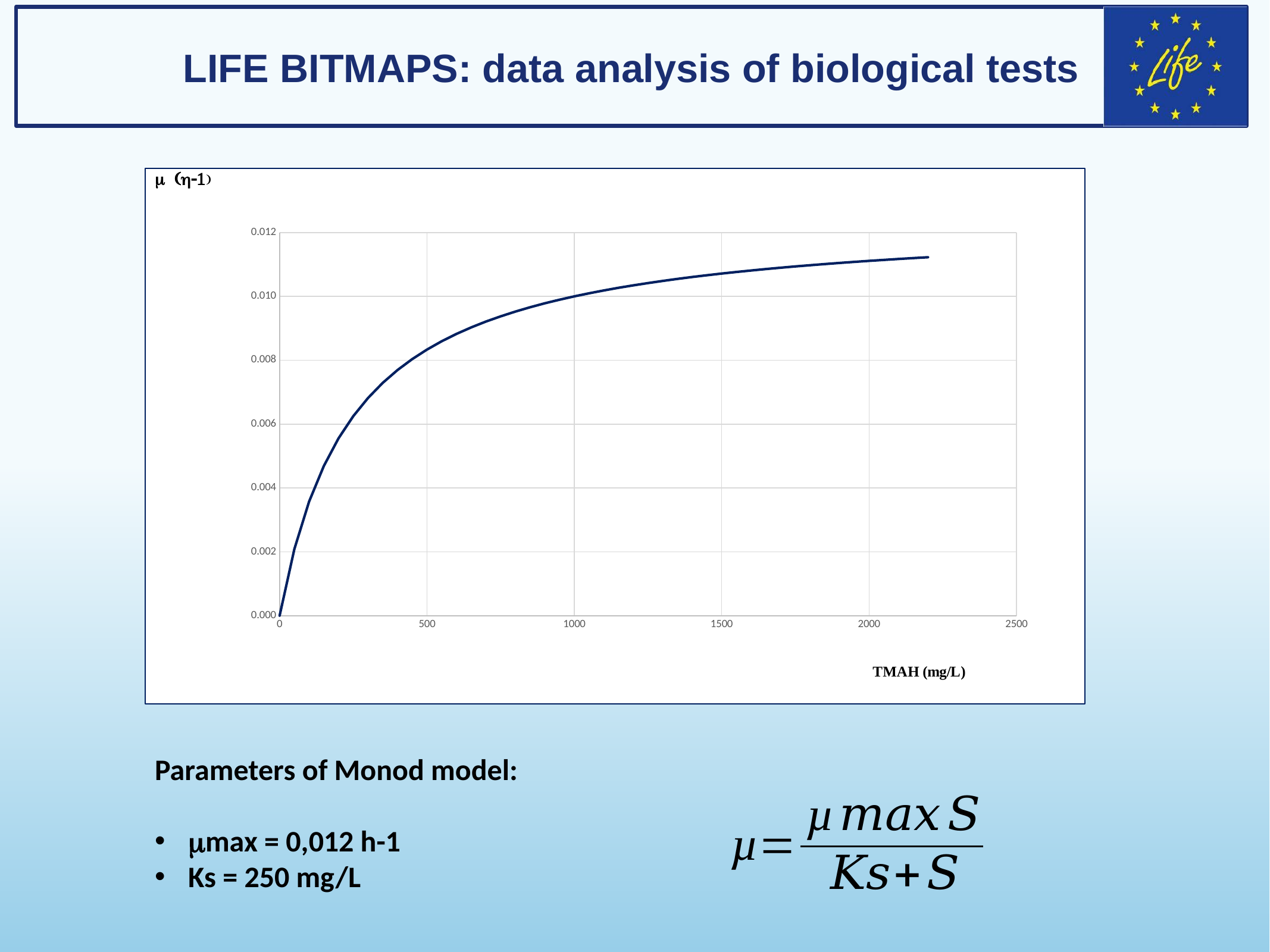
What is the title of the x axis of the chart? TMAH (mg/L) Is the value of μ at TMAH = 1500 mg/L greater or less than 0.010? greater What kind of chart is shown on the slide? line chart Is the value of μ at TMAH = 2000 mg/L greater or less than 0.012? less Is the value of μ at TMAH = 2000 mg/L larger than the value at TMAH = 500 mg/L? yes Is the value of μ at TMAH = 250 mg/L greater or less than 0.004? greater Does the value of μ rise or fall as TMAH increases along the x axis? rise What is the highest tick value shown on the x axis of the chart? 2500